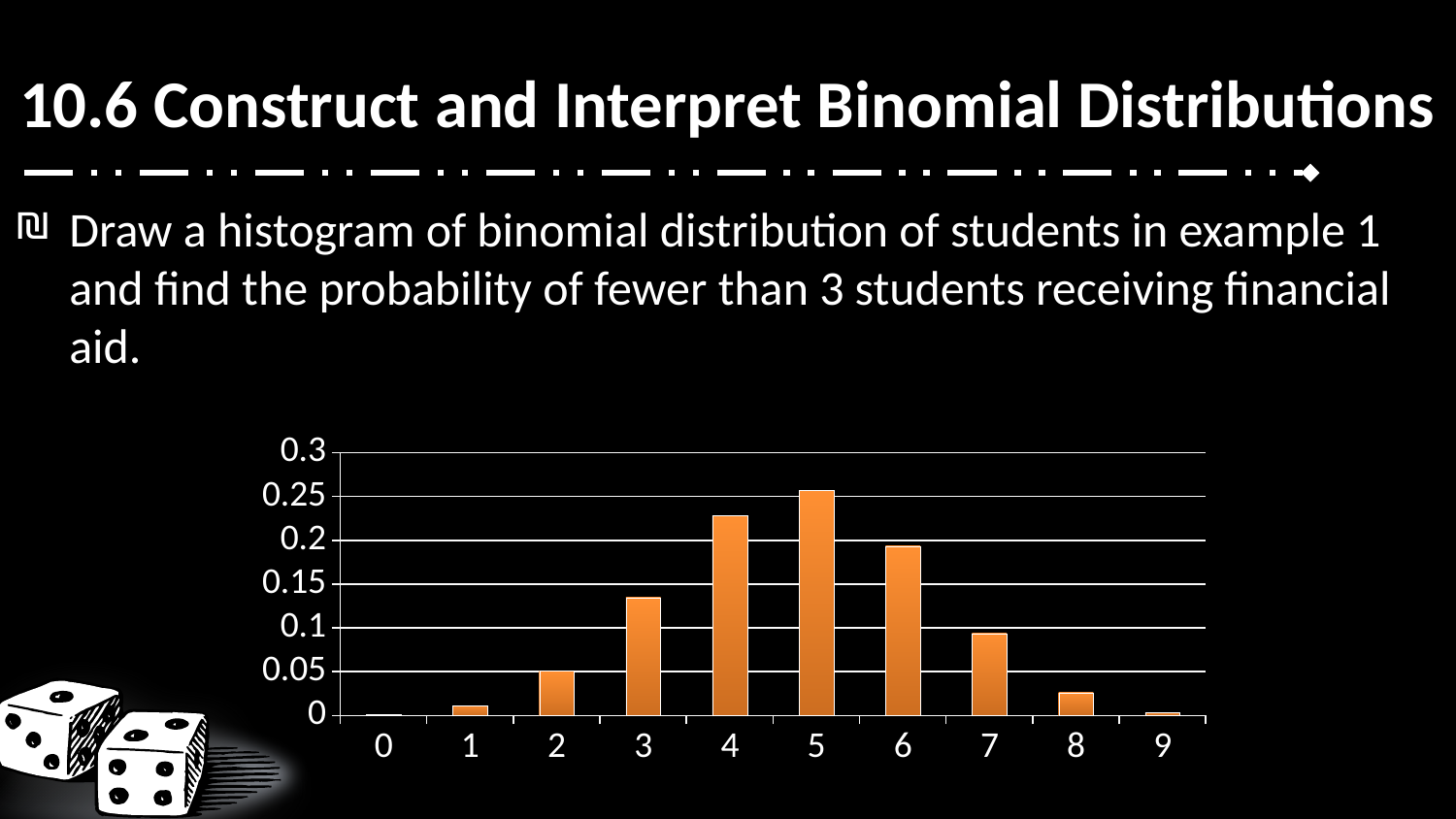
Is the value for category 6 greater or less than 0.15? greater What is the highest value labelled on the y axis of the chart? 0.3 Which category has the highest bar in the chart? 5 Is the value for category 7 greater or less than 0.1? less Is the value for category 3 greater or less than 0.15? less How many categories are shown on the x axis of the chart? 10 What kind of chart is shown on the slide? bar chart Which has the larger value, category 1 or category 8? 8 How do the values change as the categories go from 0 to 9? rise to a peak at 5, then fall Which has the larger value, category 4 or category 6? 4